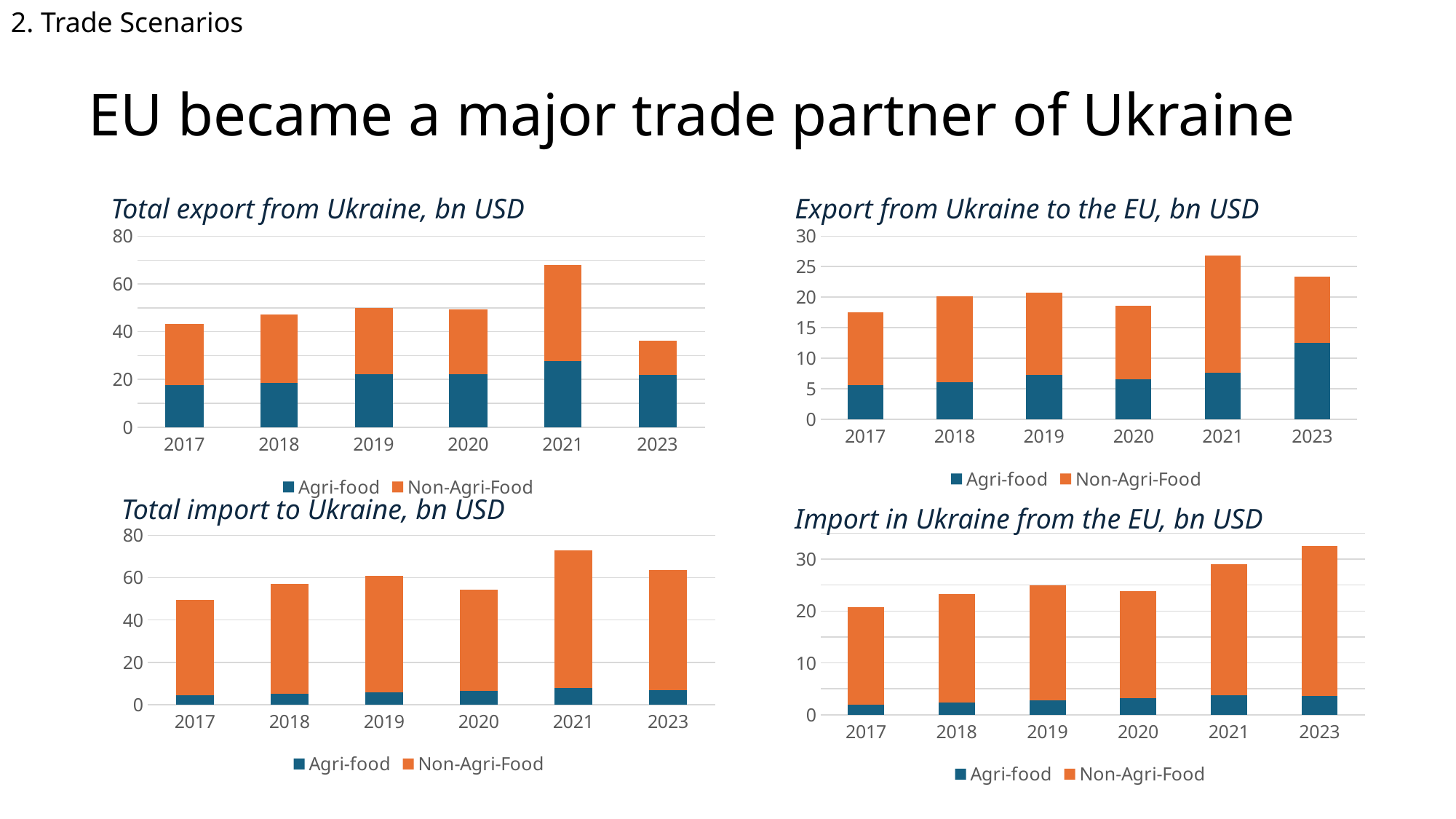
In the chart 'Export from Ukraine to the EU, bn USD', is the Agri-food value for 2023 greater or less than 10? greater In the chart 'Total export from Ukraine, bn USD', is the total bar for 2021 greater or less than 60? greater How many years are shown on the x axis of the chart 'Export from Ukraine to the EU, bn USD'? 6 What kind of chart is 'Total export from Ukraine, bn USD'? stacked bar chart In the chart 'Total export from Ukraine, bn USD', which year has the lowest total bar? 2023 In the chart 'Total import to Ukraine, bn USD', which year has the lowest total bar? 2017 In the chart 'Total export from Ukraine, bn USD', which year has the highest total bar? 2021 Which series is shown in orange in the chart 'Import in Ukraine from the EU, bn USD'? Non-Agri-Food In the chart 'Import in Ukraine from the EU, bn USD', is the total bar for 2023 larger or smaller than the total bar for 2017? larger In the chart 'Export from Ukraine to the EU, bn USD', which year has the highest total bar? 2021 In the chart 'Import in Ukraine from the EU, bn USD', which year has the highest total bar? 2023 How many series does the legend of the chart 'Total import to Ukraine, bn USD' list? 2